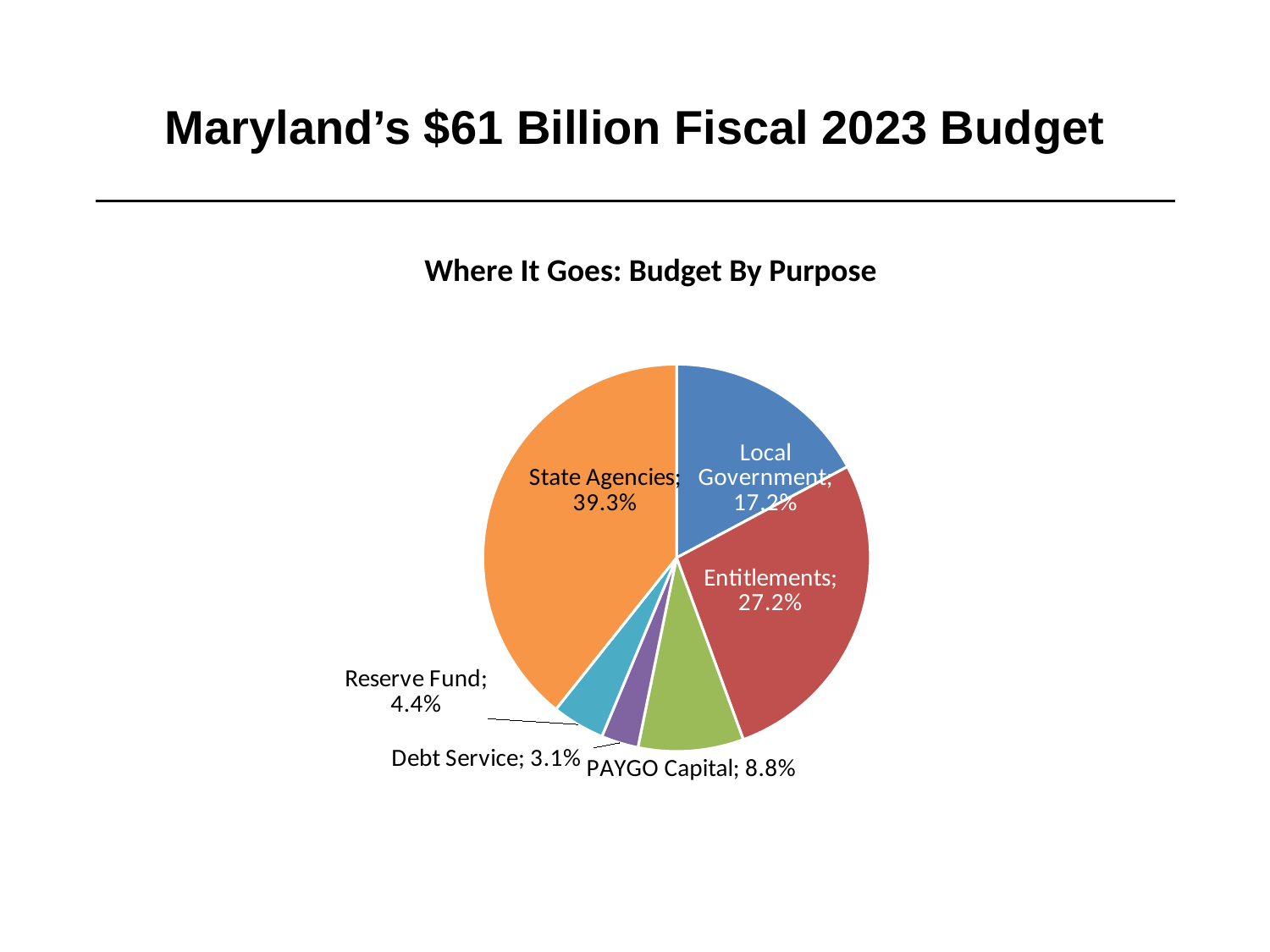
What is the difference in percentage points between State Agencies and Entitlements? 12.1 Which category has the smallest share of the budget? Debt Service What is the title of the chart? Where It Goes: Budget By Purpose Which is larger, the share for Reserve Fund or the share for Debt Service? Reserve Fund What share of the budget goes to Local Government? 17.2% What share of the budget goes to Entitlements? 27.2% How many slices does the pie chart have? 6 What share of the budget goes to Debt Service? 3.1% What share of the budget goes to PAYGO Capital? 8.8% What kind of chart is shown on the slide? Pie chart What share of the budget goes to State Agencies? 39.3% Which category has the largest share of the budget? State Agencies